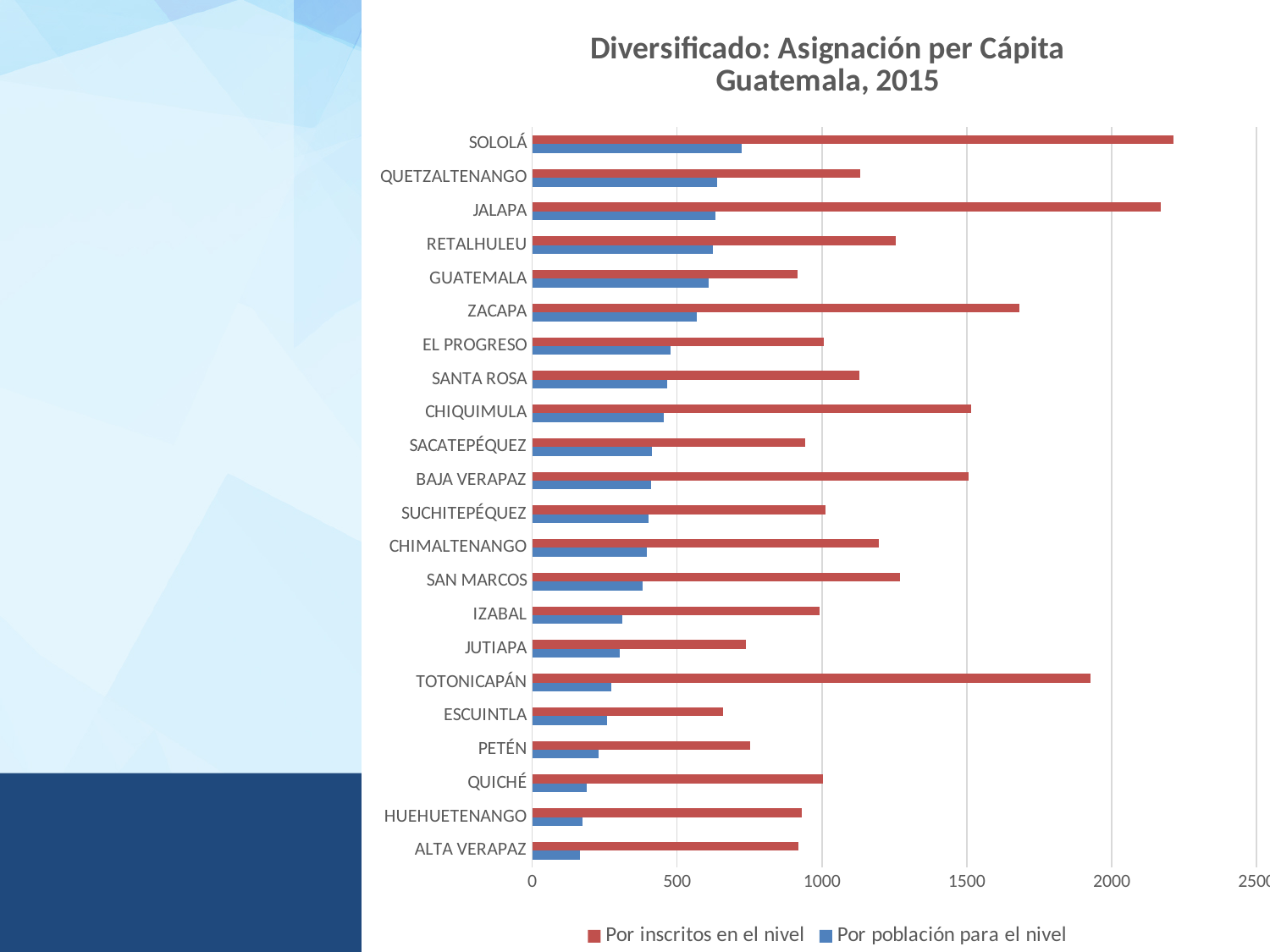
Is the 'Por inscritos en el nivel' value for Guatemala greater or less than 1000? less How many series does the legend list? 2 Is the 'Por inscritos en el nivel' value for Totonicapán greater or less than 1500? greater What kind of chart is shown on the slide? Bar chart Do the 'Por población para el nivel' values rise or fall going from Sololá at the top down to Alta Verapaz at the bottom? fall Is the 'Por población para el nivel' value for Alta Verapaz greater or less than 500? less Which has the larger 'Por inscritos en el nivel' value, Chiquimula or Santa Rosa? Chiquimula Which department has the lowest value for 'Por inscritos en el nivel'? Escuintla How many departments are plotted on the chart? 22 Which department has the highest value for 'Por población para el nivel'? Sololá What is the title of the chart? Diversificado: Asignación per Cápita Guatemala, 2015